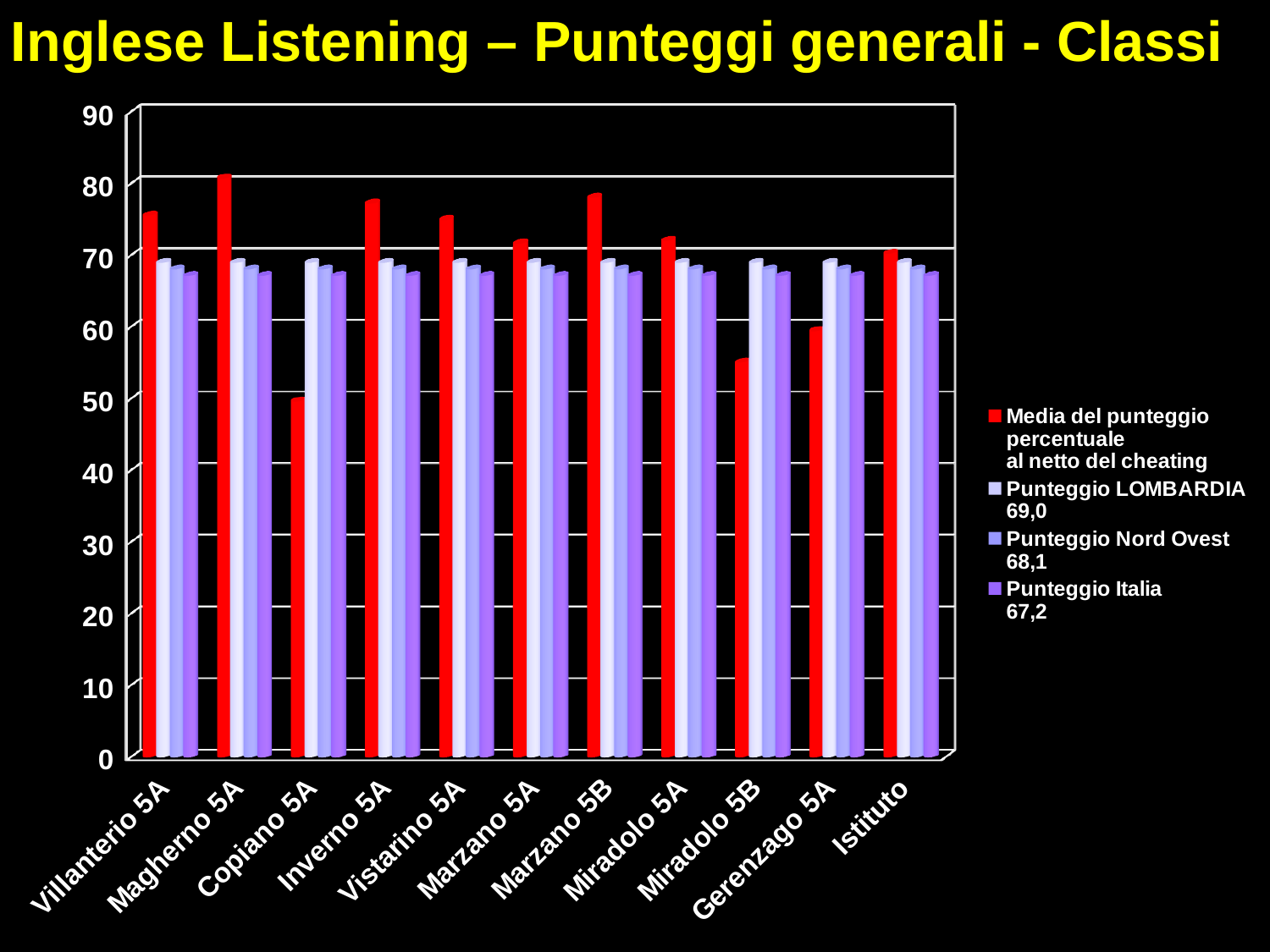
Which class has the highest Media del punteggio percentuale al netto del cheating (red bar)? Magherno 5A How many categories are shown along the x axis? 11 Which has a higher red bar value, Magherno 5A or Miradolo 5B? Magherno 5A Which class has the lowest Media del punteggio percentuale al netto del cheating (red bar)? Copiano 5A What is the Punteggio LOMBARDIA value given in the legend? 69,0 Is the red bar value for Copiano 5A greater or less than 60? less Is the red bar value for Inverno 5A greater or less than 70? greater What is the Punteggio Italia value given in the legend? 67,2 What is the title of the slide? Inglese Listening – Punteggi generali - Classi How many series does the legend list? 4 What kind of chart is shown on the slide? bar chart What is the Punteggio Nord Ovest value given in the legend? 68,1